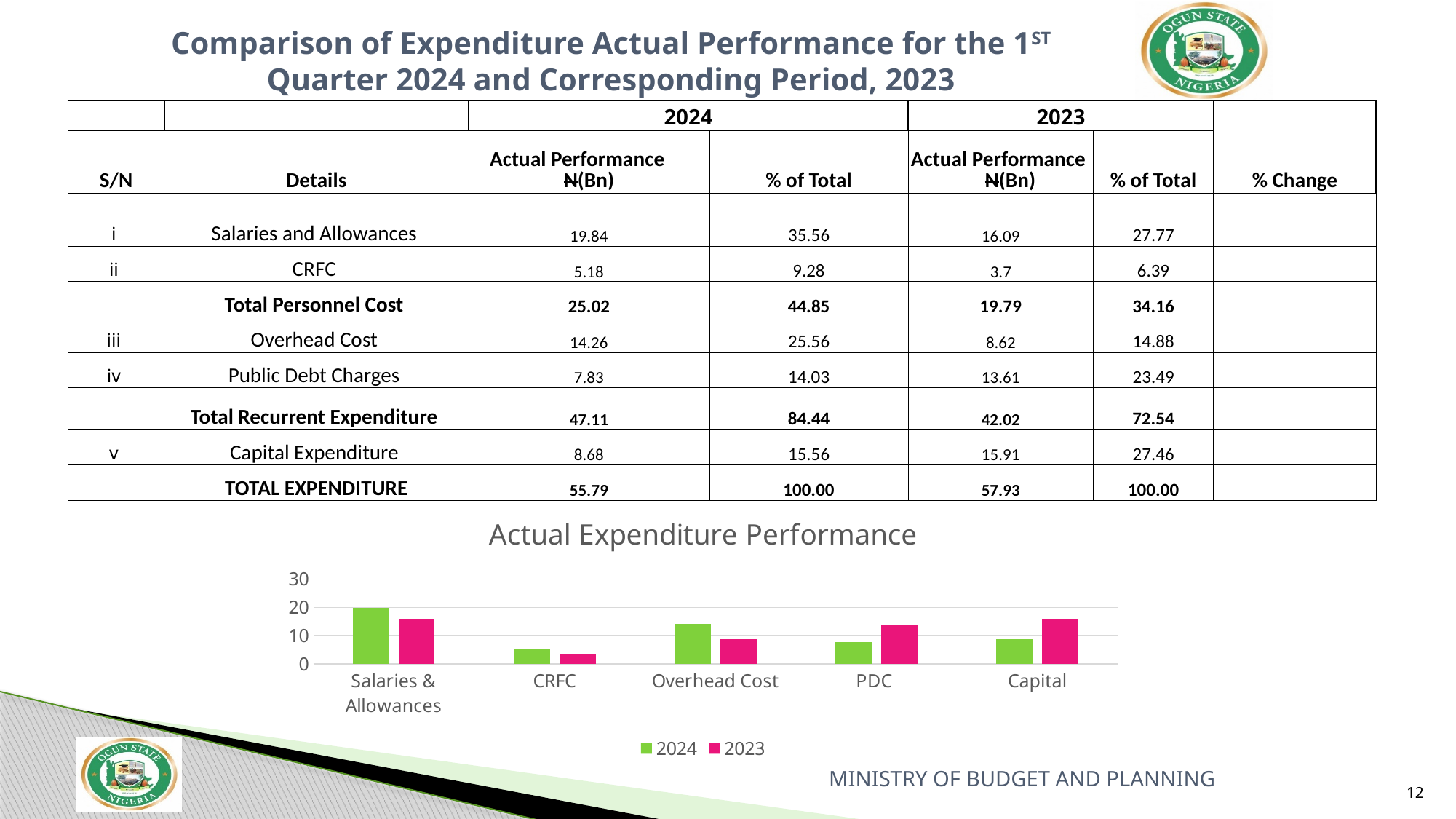
How many series does the legend of the 'Actual Expenditure Performance' chart list? 2 In the 'Actual Expenditure Performance' chart, is the 2023 value for Capital greater or less than 10? greater What colour are the 2023 bars in the 'Actual Expenditure Performance' chart? pink How many categories are shown on the x axis of the 'Actual Expenditure Performance' chart? 5 In the 'Actual Expenditure Performance' chart, which category has the lowest 2024 value? CRFC In the 'Actual Expenditure Performance' chart, is the PDC value larger for 2024 or 2023? 2023 In the 'Actual Expenditure Performance' chart, is the 2024 value for Salaries & Allowances greater or less than 10? greater In the 'Actual Expenditure Performance' chart, which category has the lowest 2023 value? CRFC What kind of chart is the 'Actual Expenditure Performance' chart? bar chart In the 'Actual Expenditure Performance' chart, which category has the highest 2024 value? Salaries & Allowances In the 'Actual Expenditure Performance' chart, is the Overhead Cost value larger for 2024 or 2023? 2024 In the 'Actual Expenditure Performance' chart, is the 2023 value for CRFC greater or less than 10? less